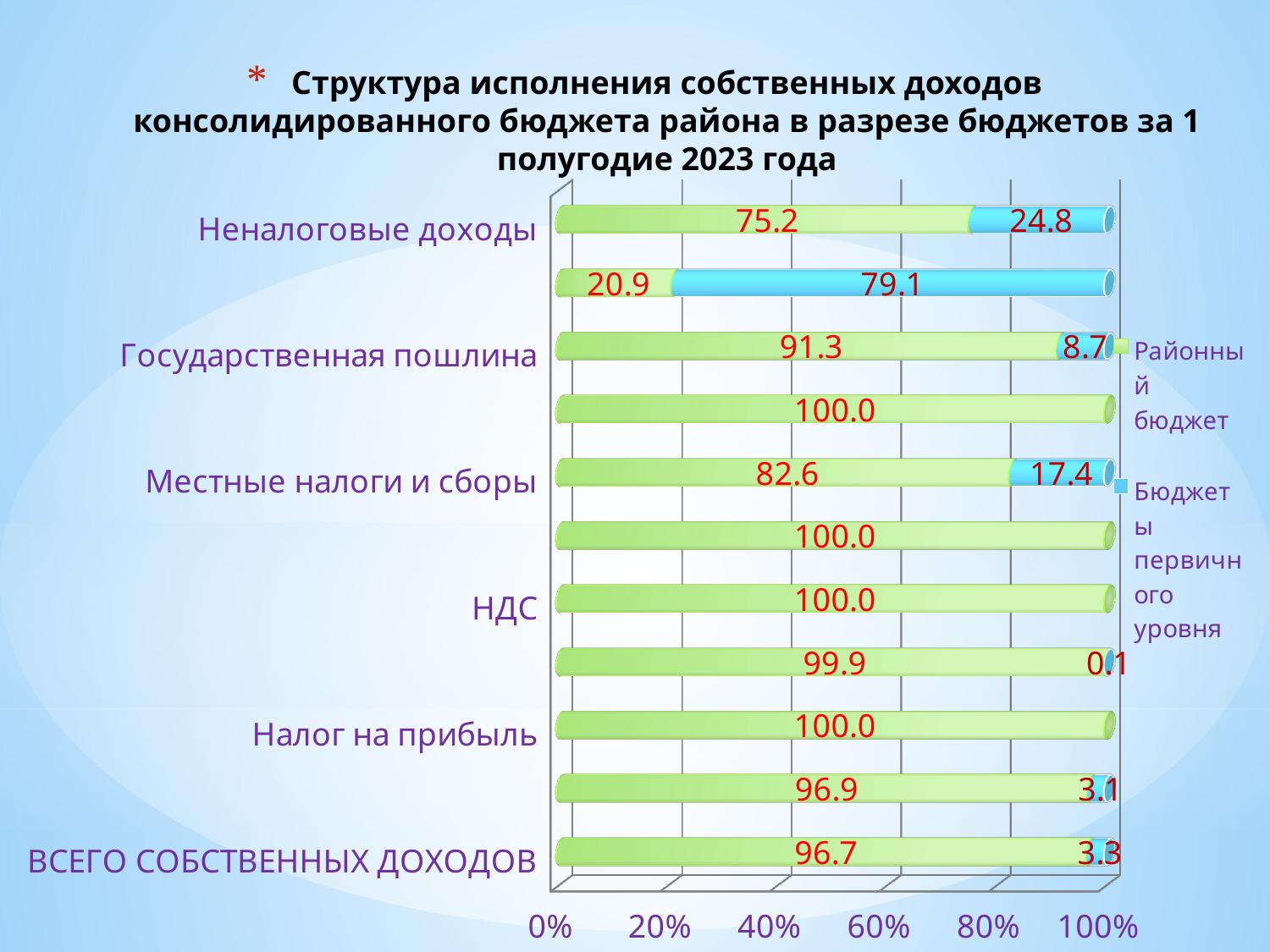
What is the total of the stacked bar for Местные налоги и сборы? 100.0 What is the value of Бюджеты первичного уровня for Местные налоги и сборы? 17.4 What is the value of Районный бюджет for НДС? 100.0 Which has the larger Районный бюджет value: Неналоговые доходы or Государственная пошлина? Государственная пошлина What is the value of Районный бюджет for Неналоговые доходы? 75.2 What is the value of Бюджеты первичного уровня for ВСЕГО СОБСТВЕННЫХ ДОХОДОВ? 3.3 How many series does the legend list? 2 What kind of chart is shown on the slide? Stacked bar chart What is the value of Районный бюджет for Государственная пошлина? 91.3 What is the difference between the Районный бюджет and Бюджеты первичного уровня values for Неналоговые доходы? 50.4 Which colour represents Районный бюджет in the legend? Green What is the value of Бюджеты первичного уровня for Неналоговые доходы? 24.8